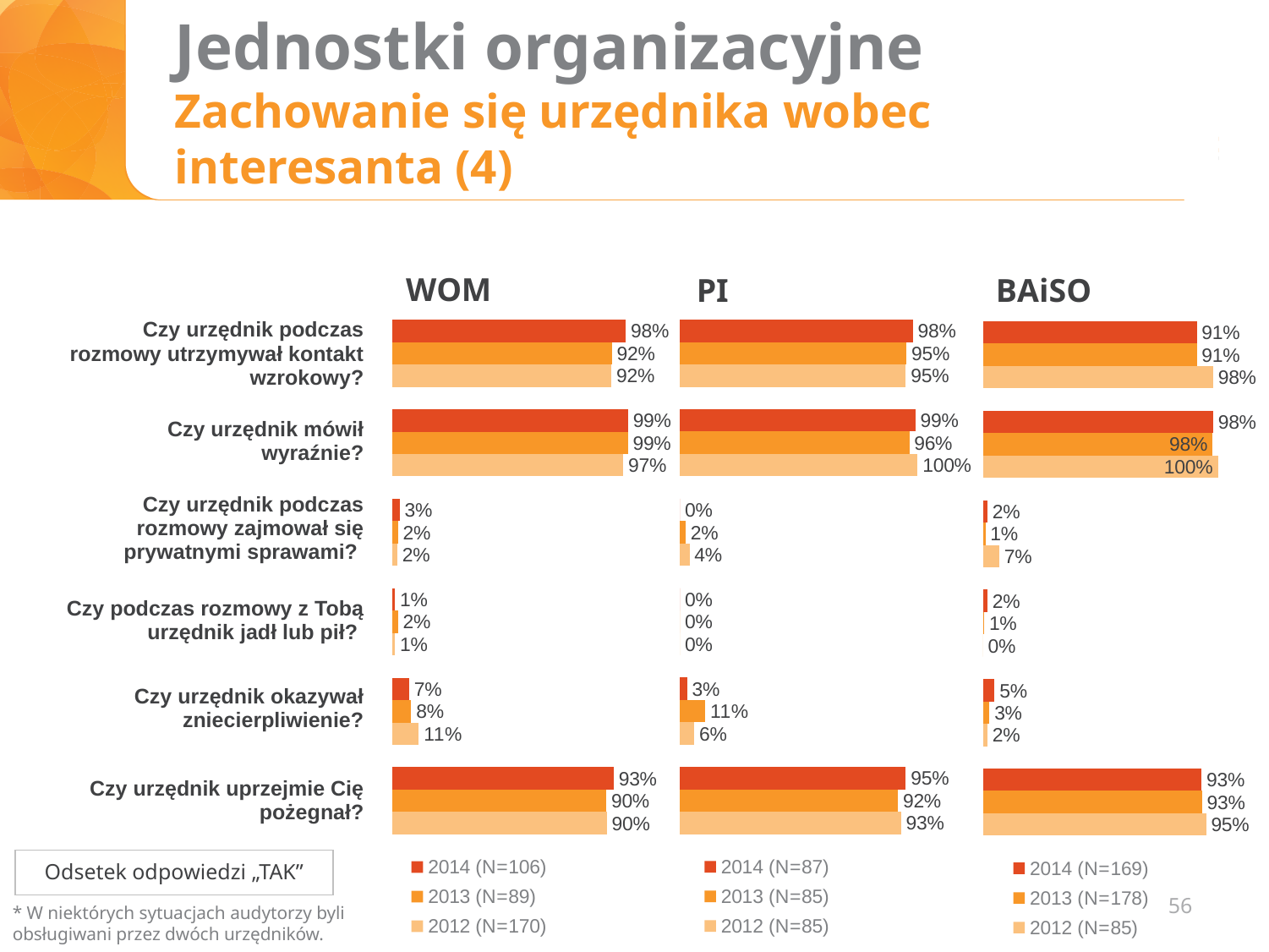
In the PI chart, what is the 2012 value for "Czy urzędnik mówił wyraźnie?"? 100% How many question categories are shown in the PI chart? 6 What kind of chart is the BAiSO chart? Bar chart In the WOM chart, what is the difference between the 2014 and 2013 values for "Czy urzędnik podczas rozmowy utrzymywał kontakt wzrokowy?"? 6% In the PI chart, which year has the lowest value for "Czy urzędnik okazywał zniecierpliwienie?"? 2014 In the PI chart, what is the 2013 value for "Czy urzędnik okazywał zniecierpliwienie?"? 11% In the BAiSO chart, what is the 2012 value for "Czy urzędnik podczas rozmowy zajmował się prywatnymi sprawami?"? 7% In the WOM chart, what is the 2014 value for "Czy urzędnik podczas rozmowy utrzymywał kontakt wzrokowy?"? 98% In the WOM chart, which year has the highest value for "Czy urzędnik okazywał zniecierpliwienie?"? 2012 In the BAiSO chart, which year has the higher value for "Czy urzędnik uprzejmie Cię pożegnał?": 2014 or 2012? 2012 How many series does the legend of the WOM chart list? 3 According to the legend of the BAiSO chart, what is the sample size (N) for 2013? N=178